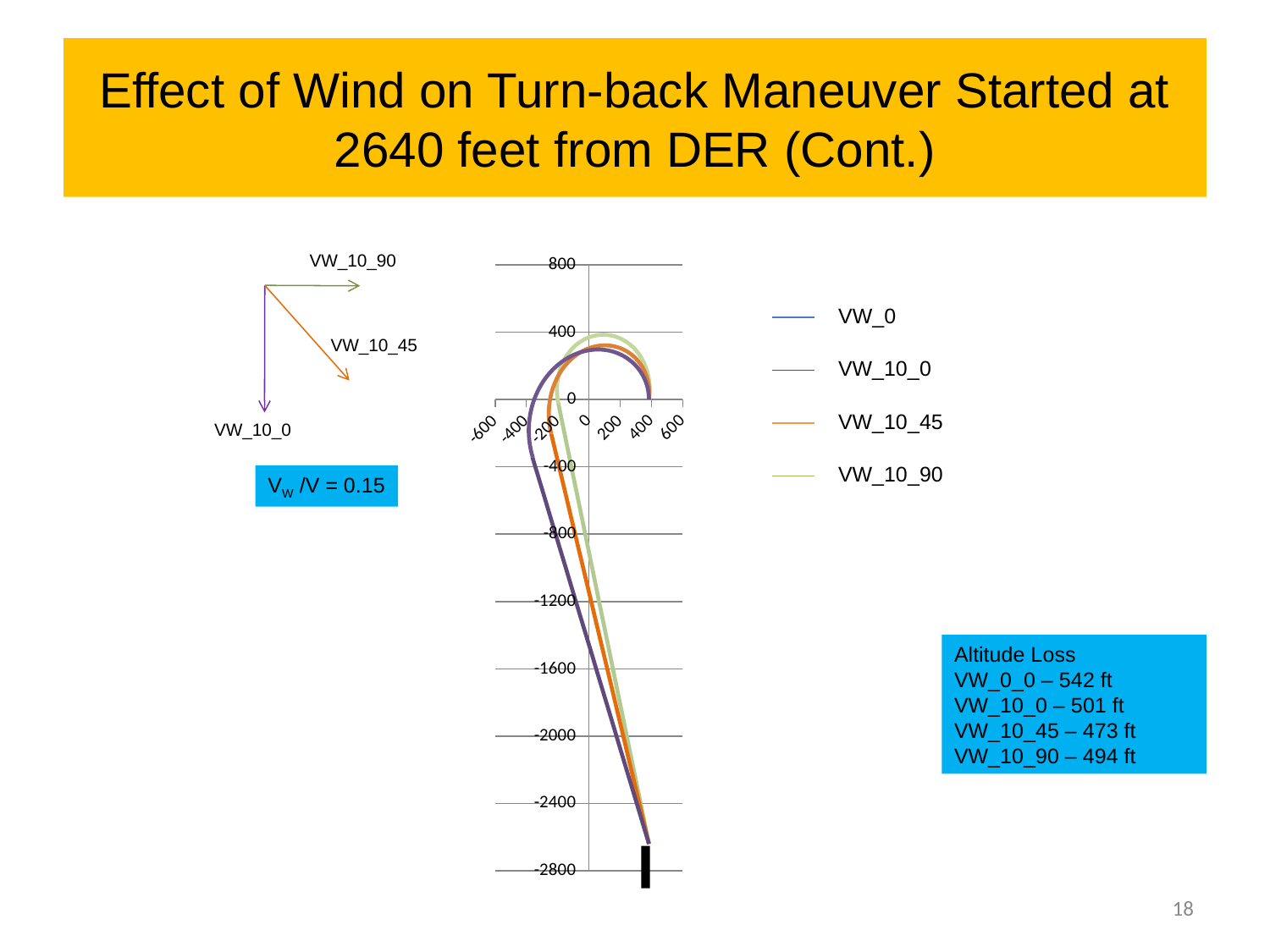
Is the leftmost horizontal-axis value reached by the VW_0 curve greater or less than -600? greater How many series does the chart legend list? 4 What is the name of the first series listed in the chart legend? VW_0 Is the highest vertical-axis value reached by the VW_10_90 curve greater or less than 0? greater Which curve reaches the highest point on the vertical axis, VW_10_90 or VW_0? VW_10_90 Is the highest vertical-axis value reached by the VW_10_90 curve greater or less than 800? less Which series in the chart legend is drawn in orange? VW_10_45 What kind of chart is shown on the slide? line chart